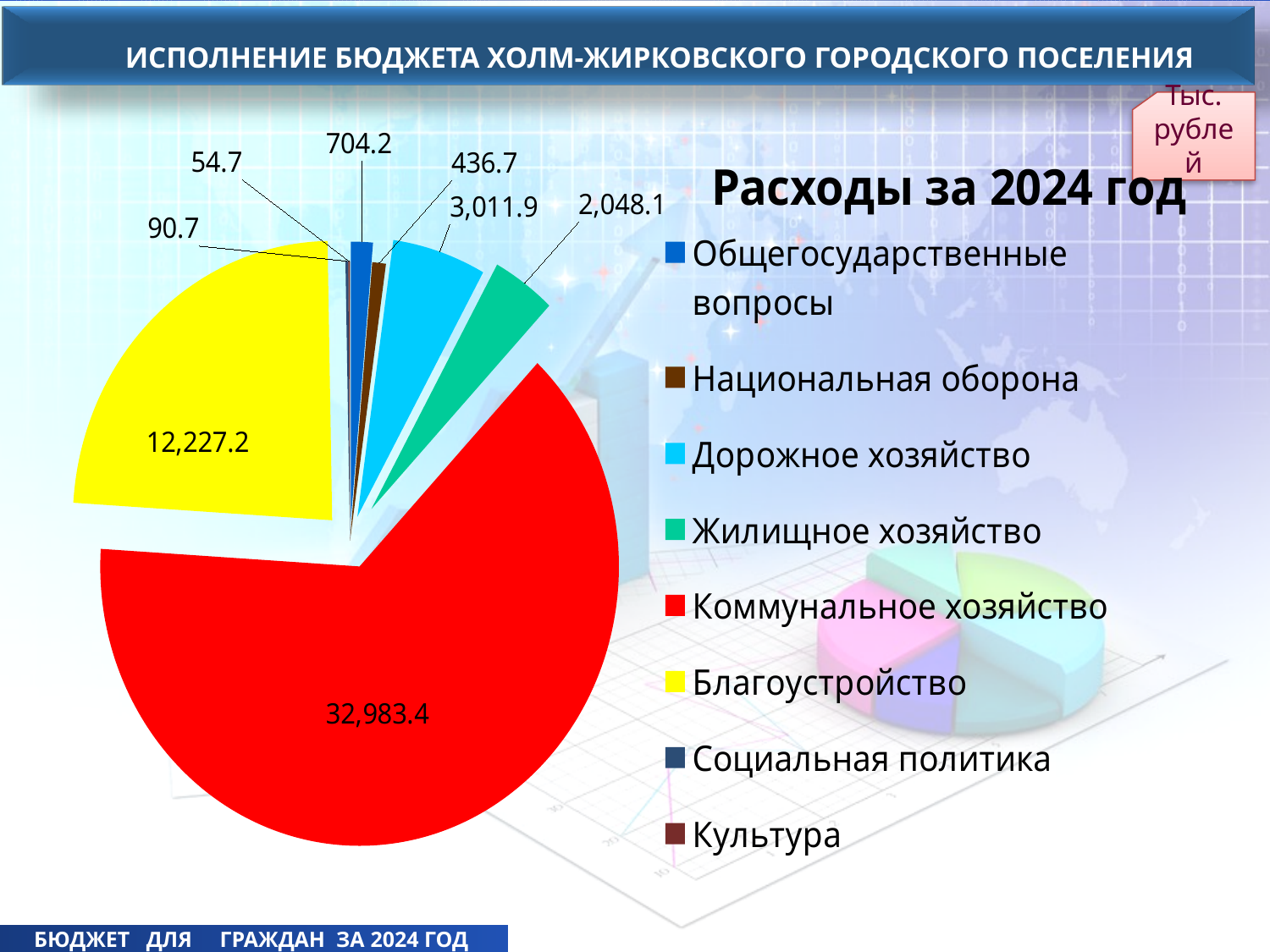
How many categories does the legend of the pie chart list? 8 What is the value for Коммунальное хозяйство? 32,983.4 What is the value for Благоустройство? 12,227.2 What is the value for Жилищное хозяйство? 2,048.1 What is the difference between the values for Коммунальное хозяйство and Благоустройство? 20,756.2 Which category has the largest slice of the pie? Коммунальное хозяйство What type of chart is shown on the slide? pie chart What is the value for Дорожное хозяйство? 3,011.9 What is the title of the chart? Расходы за 2024 год Which is larger, the value for Дорожное хозяйство or the value for Жилищное хозяйство? Дорожное хозяйство What is the value for Общегосударственные вопросы? 704.2 Which category has the smallest value in the pie chart? Культура